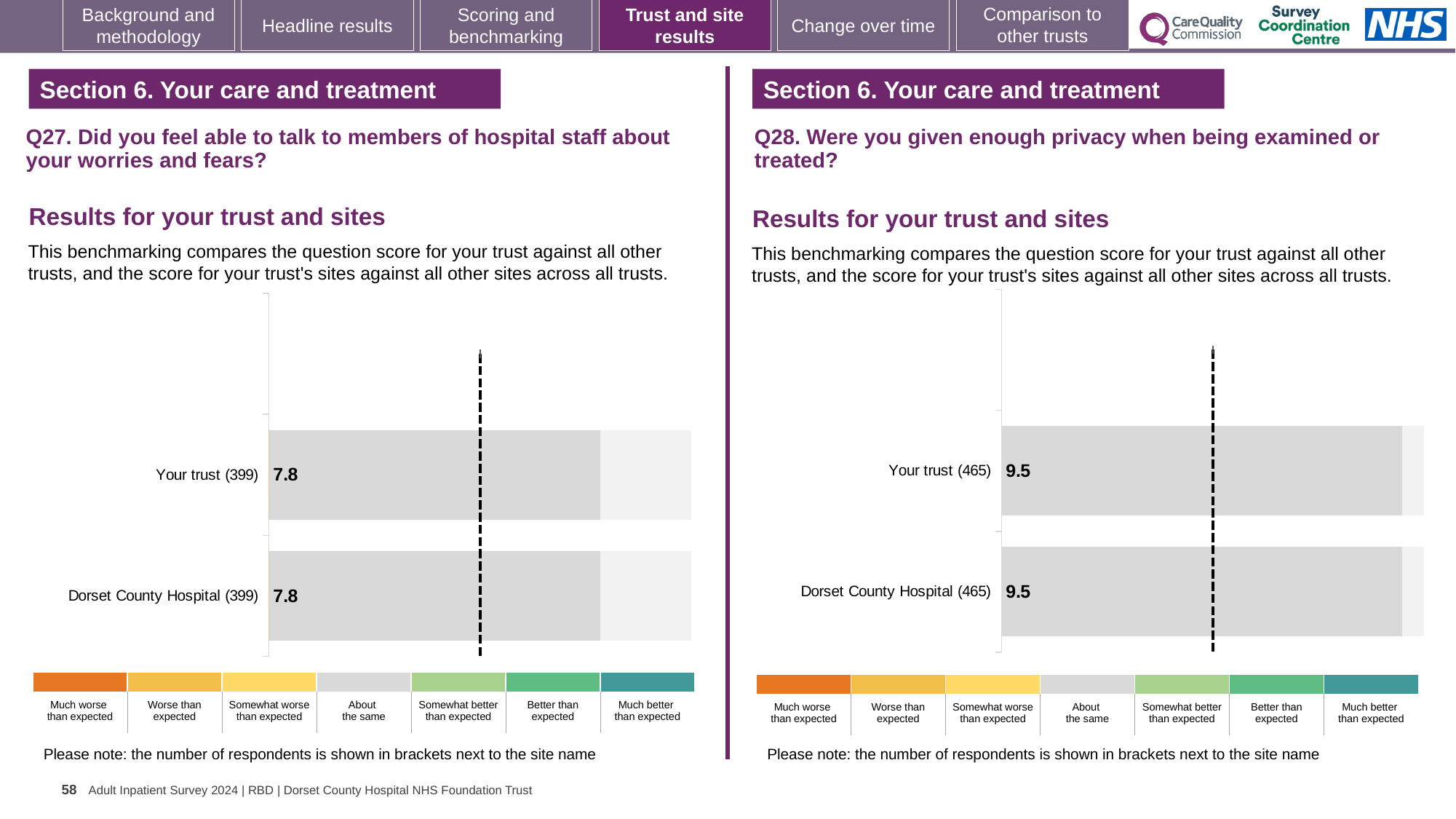
On the Q27 chart (left), how many respondents are shown in brackets next to Your trust? 399 On the Q28 chart (right), how many respondents are shown in brackets next to Dorset County Hospital? 465 What kind of chart is the Q27 chart (left)? Bar chart How many bars are plotted on the Q28 chart (right)? 2 How many categories does the colour key below the Q28 chart (right) list? 7 On the Q27 chart (left), what is the difference between the score for Your trust and the score for Dorset County Hospital? 0.0 On the Q27 chart (left), what is the score for Dorset County Hospital? 7.8 How many bars are plotted on the Q27 chart (left)? 2 On the Q28 chart (right), what is the score for Your trust? 9.5 On the Q28 chart (right), what is the score for Dorset County Hospital? 9.5 On the Q28 chart (right), what is the difference between the score for Your trust and the score for Dorset County Hospital? 0.0 On the Q27 chart (left), what is the score for Your trust? 7.8